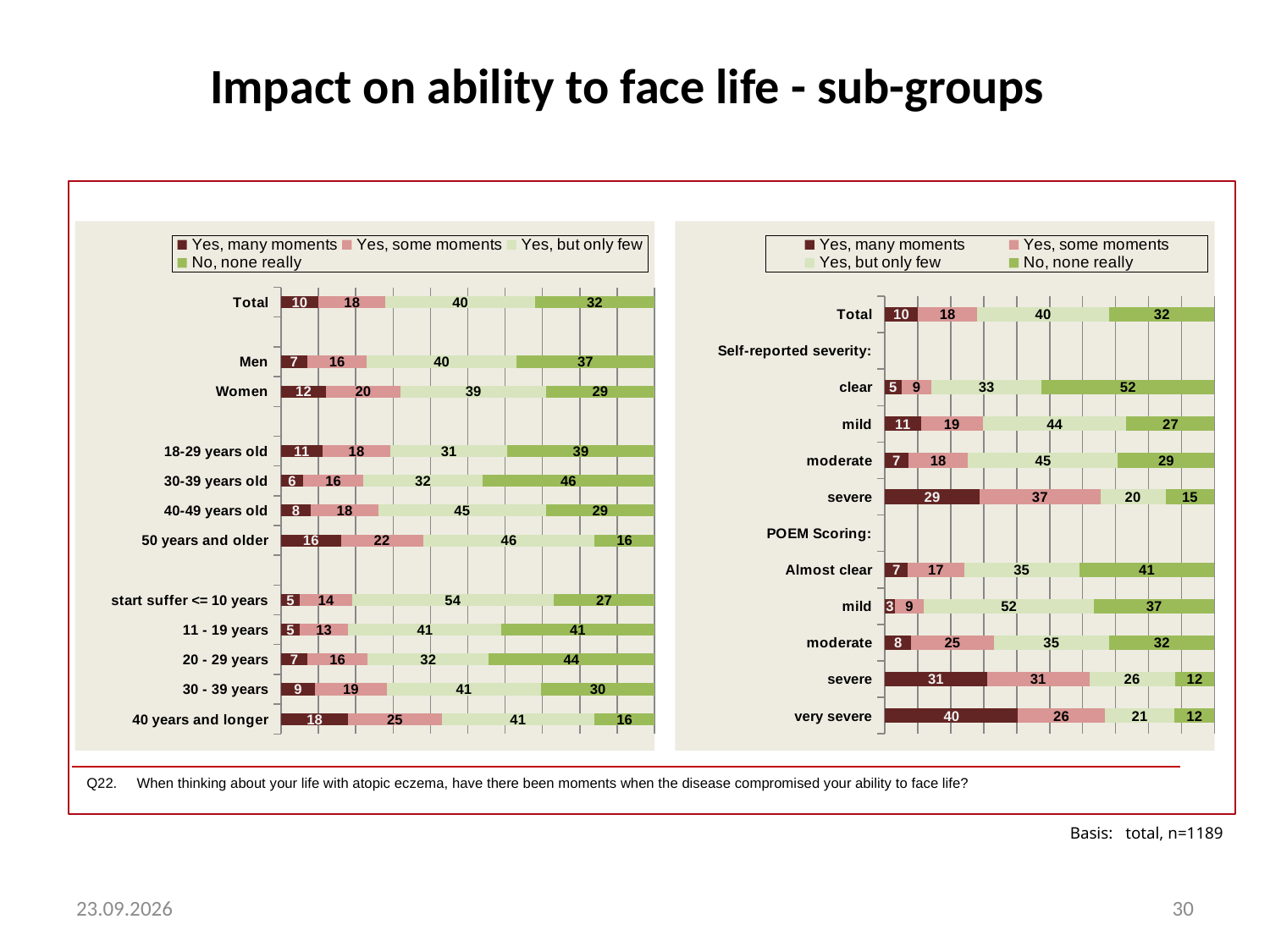
What kind of chart is the left chart? Stacked bar chart In the right chart, which group has the lowest "Yes, many moments" value? POEM Scoring "mild" In the left chart, which category has the highest value for "No, none really"? 30-39 years old In the right chart, which self-reported severity group has the highest "No, none really" value? clear In the left chart, what is the value for "Yes, many moments" for Women? 12 In the right chart, which has the larger "Yes, some moments" value: self-reported severity "severe" or POEM Scoring "severe"? Self-reported severity "severe" How many categories (bars) are plotted in the left chart? 12 In the left chart, what is the difference between the "Yes, some moments" values for Women and Men? 4 In the left chart, what is the "Yes, but only few" value for "start suffer <= 10 years"? 54 In the right chart, what is the total of the stacked bar for the self-reported severity "clear" group? 99 How many series does the legend of the left chart list? 4 In the right chart, what is the "Yes, many moments" value for the POEM Scoring "very severe" group? 40